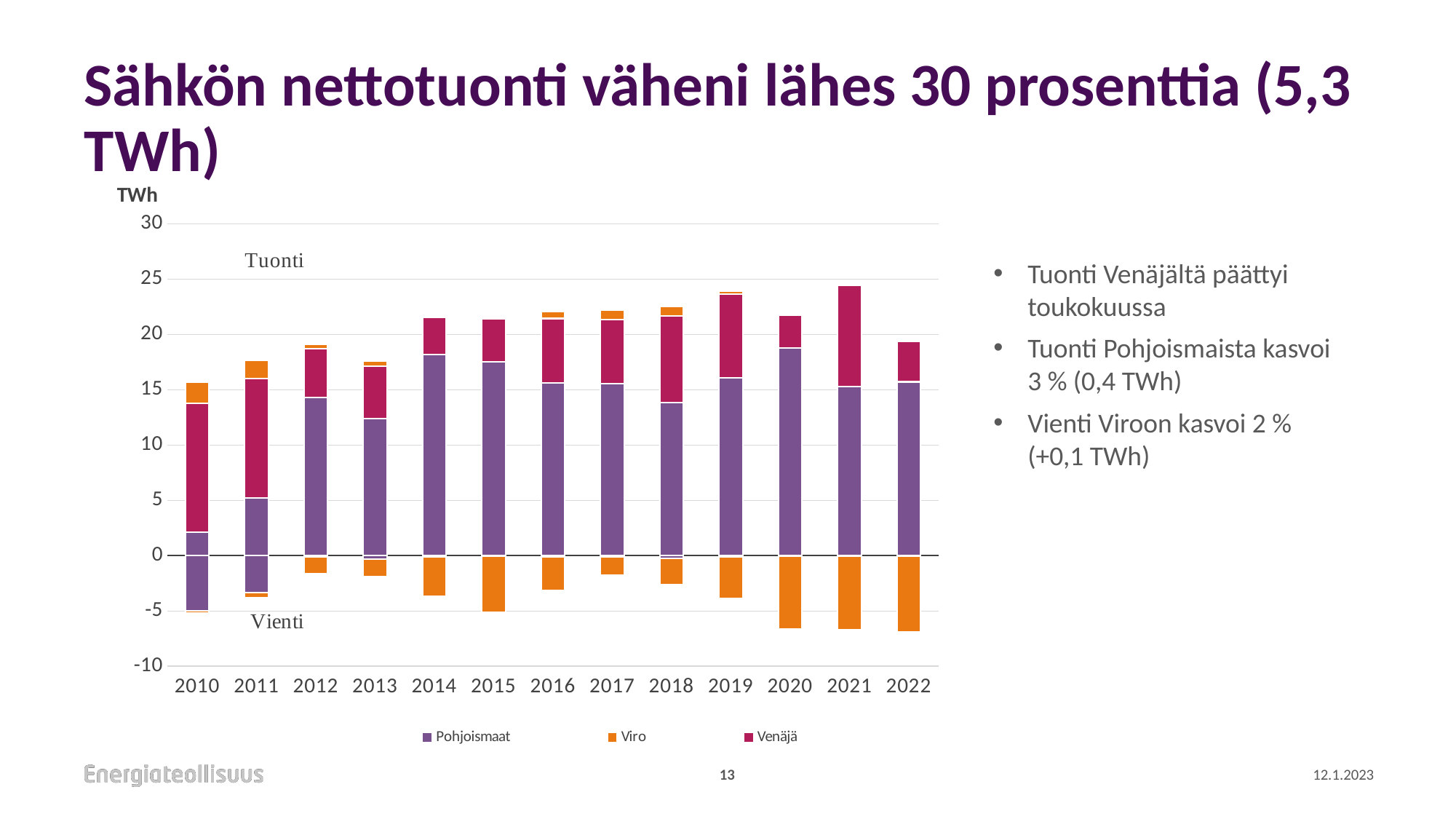
Is the Pohjoismaat import value for 2010 greater or less than 5? less Which series are listed in the chart legend? Pohjoismaat, Viro, Venäjä Is the Pohjoismaat import value for 2020 greater or less than 15? greater Which year has the larger Pohjoismaat import segment, 2010 or 2022? 2022 Is the Viro export value for 2022 greater or less than -5? less Does the Pohjoismaat import segment rise or fall from 2010 to 2014? rise What unit is shown on the y axis of the chart? TWh What kind of chart is shown on the slide? Stacked bar chart How many years are shown on the x axis of the chart? 13 How many series does the chart legend list? 3